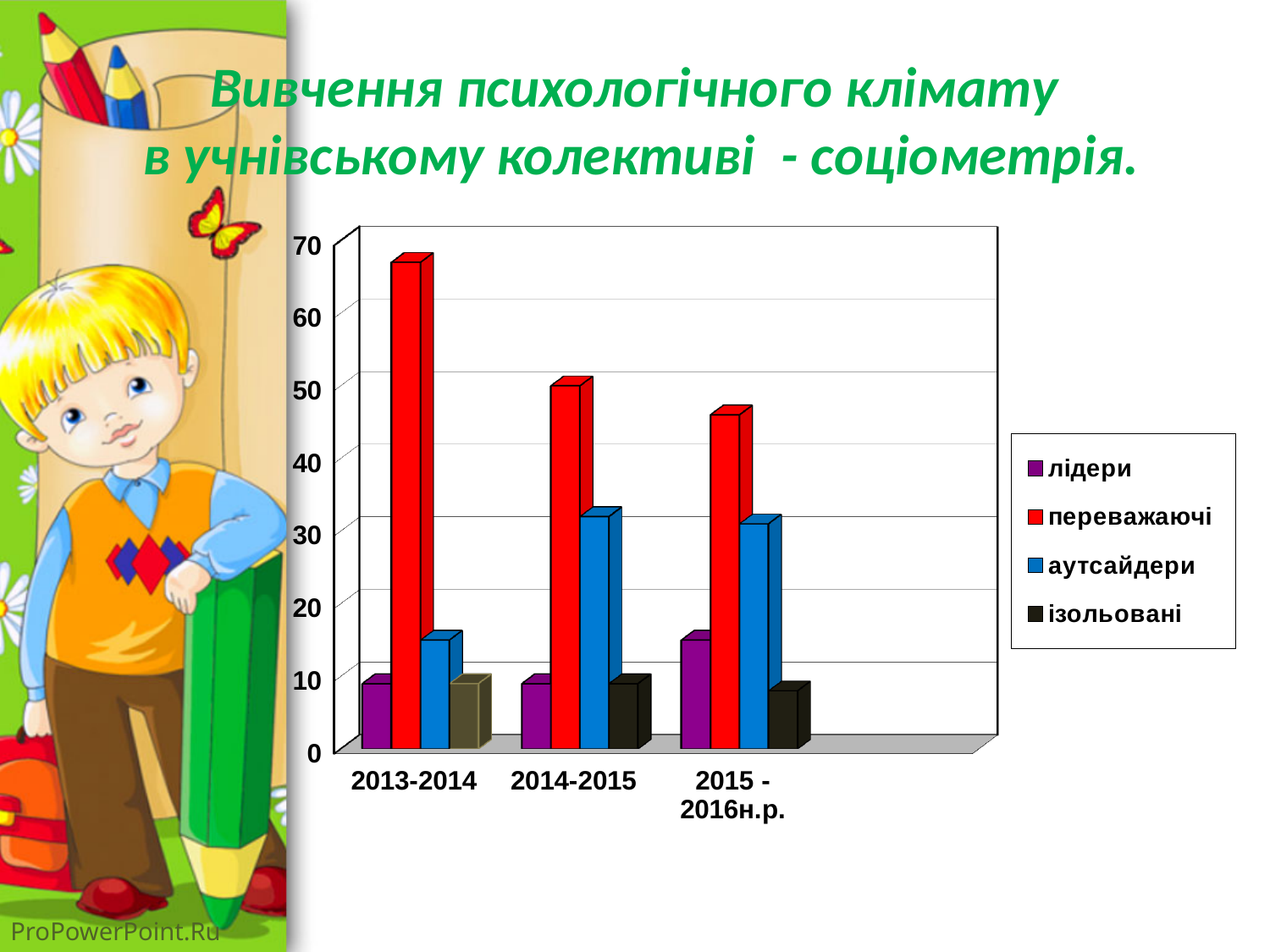
How many school-year categories are shown on the x axis? 3 Is the value for аутсайдери in 2013-2014 greater or less than 20? less Do the values for переважаючі rise or fall from 2013-2014 to 2015-2016н.р.? fall How many series does the legend list? 4 Which series has the highest value in 2015-2016н.р.? переважаючі Is the value for переважаючі in 2015-2016н.р. greater or less than 50? less Is the value for переважаючі in 2013-2014 greater or less than 60? greater What kind of chart is shown on the slide? bar chart Which is larger: аутсайдери in 2013-2014 or аутсайдери in 2014-2015? 2014-2015 In which school year is the value for переважаючі the highest? 2013-2014